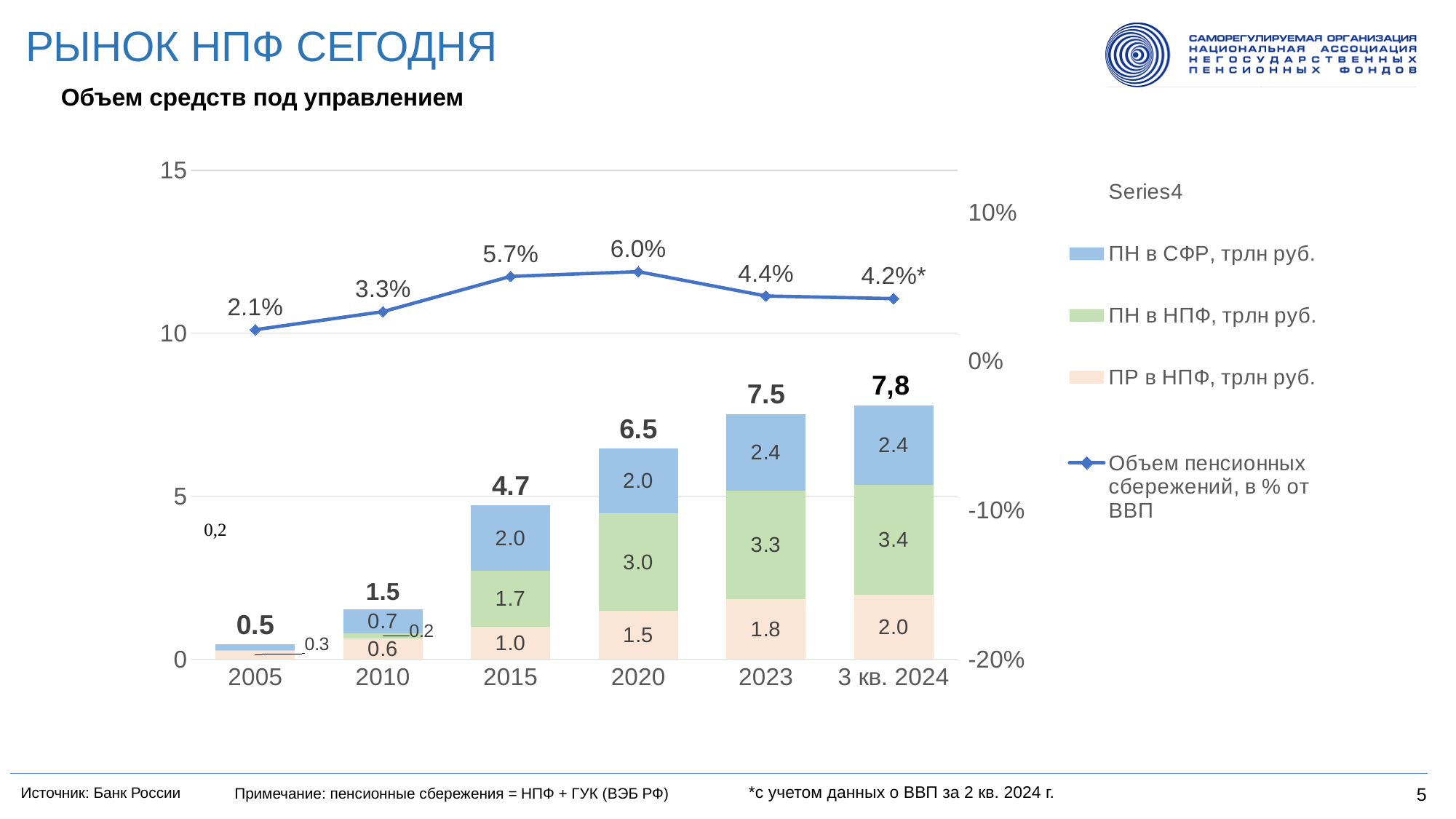
What is the difference between ПН в НПФ, трлн руб. in 2023 and in 2015? 1.6 What kind of chart is shown on the slide? Combined stacked bar and line chart Which category has the lowest stacked bar total? 2005 In which year does the line Объем пенсионных сбережений, в % от ВВП reach its highest value? 2020 Does the line Объем пенсионных сбережений, в % от ВВП rise or fall from 2020 to 3 кв. 2024? Fall How many categories are shown on the x axis? 6 What is the total labelled above the stacked bar for 3 кв. 2024? 7,8 In 2020, which is larger: ПН в НПФ, трлн руб. or ПН в СФР, трлн руб.? ПН в НПФ, трлн руб. What is the value of ПН в СФР, трлн руб. for 2023? 2.4 What is the value of ПР в НПФ, трлн руб. for 2020? 1.5 What is the value of Объем пенсионных сбережений, в % от ВВП for 2015? 5.7% What is the total of the stacked bar for 2020? 6.5